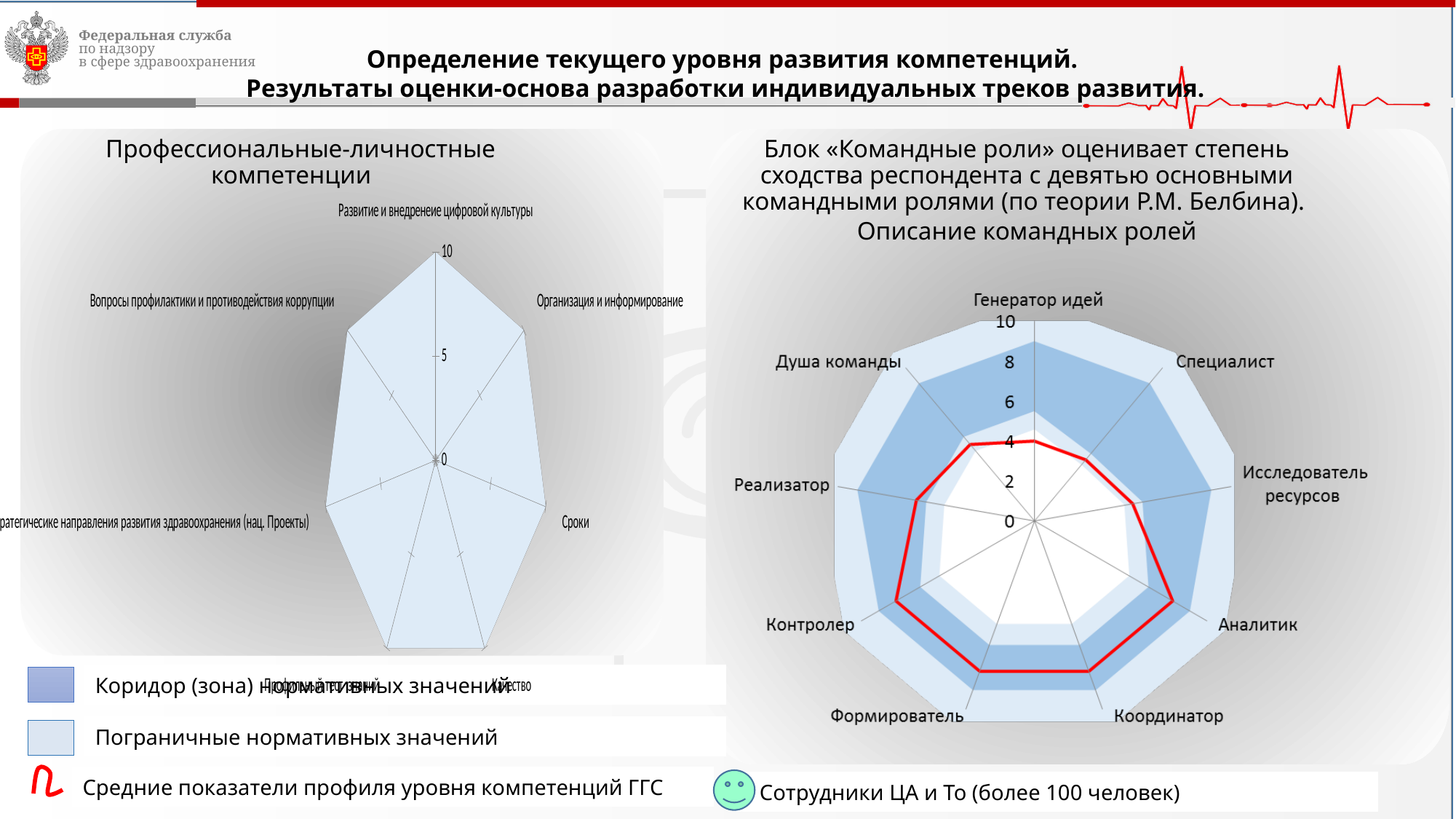
What kind of chart is the chart on the right side of the slide (team roles)? radar chart On the team roles chart on the right, is the red-line value for Координатор greater or less than 6? greater On the left chart (Профессиональные-личностные компетенции), what is the maximum value shown on the axis scale? 10 On the team roles chart on the right, which has the larger red-line value: Аналитик or Генератор идей? Аналитик On the team roles chart on the right, is the red-line value for Аналитик greater or less than 6? greater On the team roles chart on the right, what is the maximum value shown on the axis scale? 10 What kind of chart is the chart on the left side of the slide (Профессиональные-личностные компетенции)? radar chart On the team roles chart on the right, is the red-line value for Генератор идей greater or less than 6? less According to the legend at the bottom of the slide, what does the red line on the charts represent? Средние показатели профиля уровня компетенций ГГС On the team roles chart on the right, how many team roles (axes) are shown? 9